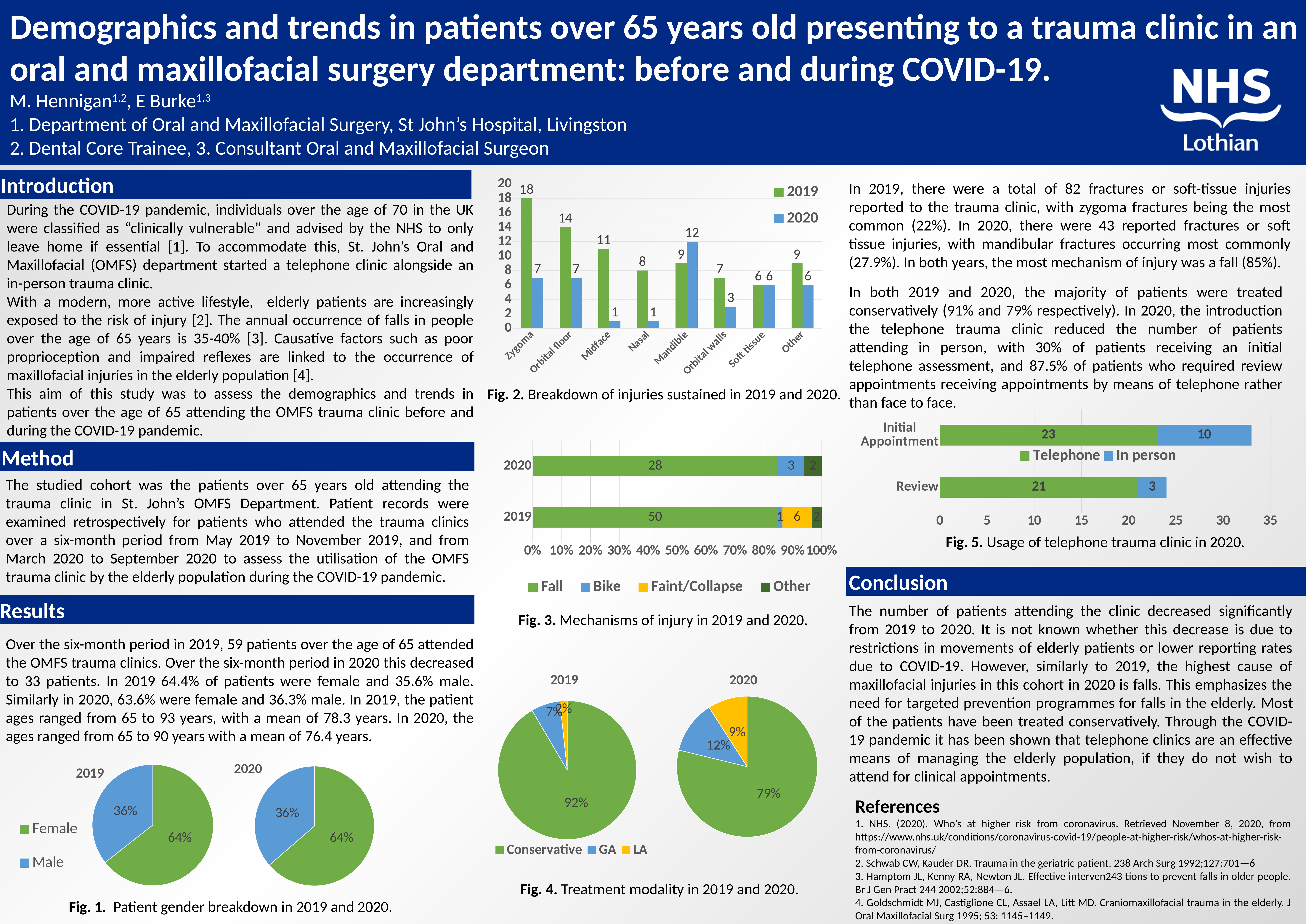
In Fig. 2, how many injury categories are shown on the x axis? 8 In Fig. 5, how many review appointments were in person? 3 In Fig. 3, how many patients had a fall as the mechanism of injury in 2019? 50 In Fig. 3, how many series does the legend list? 4 In Fig. 2, which is larger for mandible: the 2019 value or the 2020 value? 2020 What kind of chart is Fig. 1? Pie chart In Fig. 2, what was the number of zygoma injuries in 2019? 18 In Fig. 4, what share of patients in 2020 were treated conservatively? 79% In Fig. 2, what was the number of mandible injuries in 2020? 12 In Fig. 2, what is the difference between the 2019 and 2020 values for orbital floor? 7 In Fig. 5, what is the total number of initial appointments (telephone plus in person)? 33 In Fig. 2, which injury category had the highest value in 2019? Zygoma